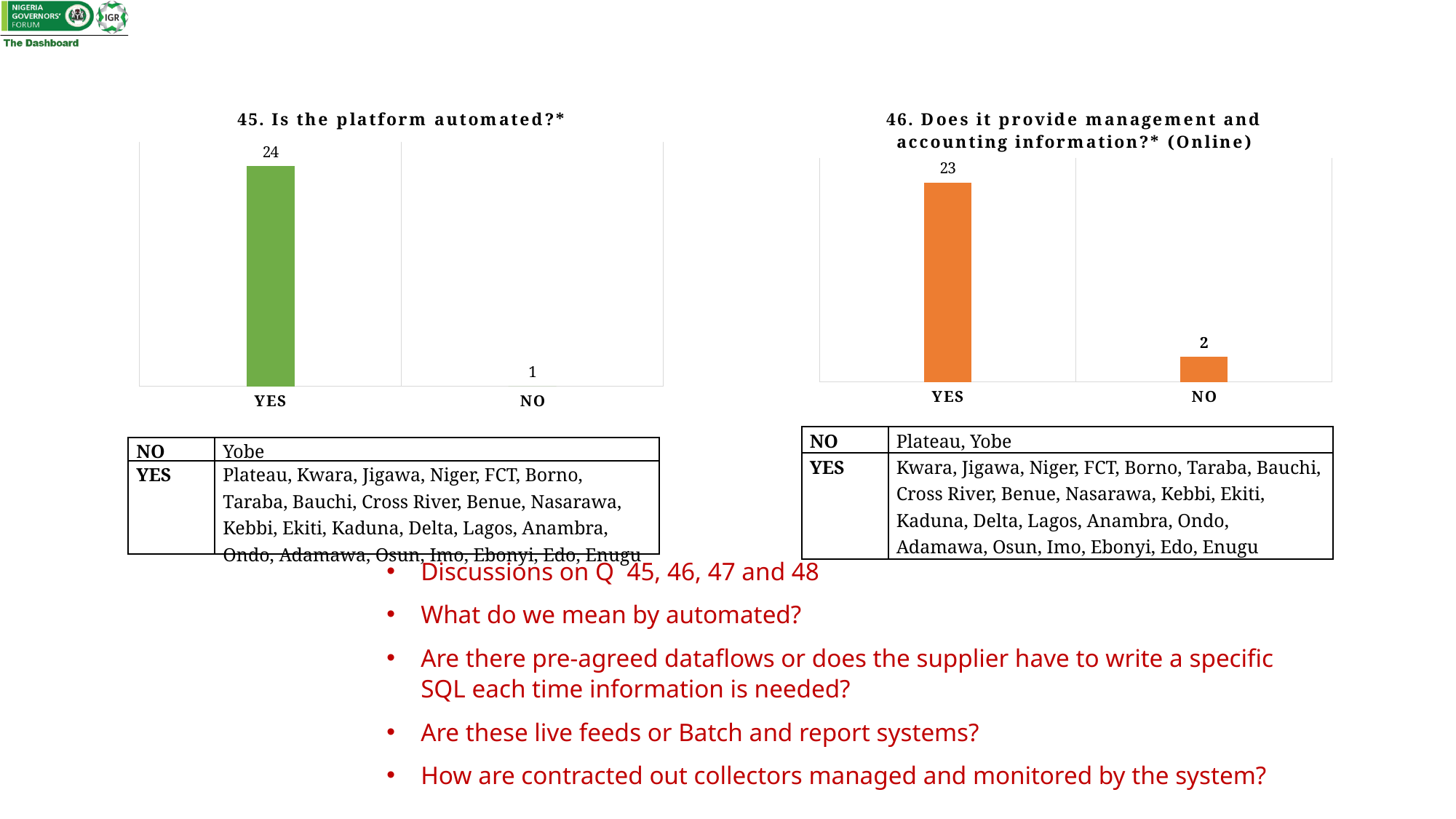
In the chart titled "46. Does it provide management and accounting information?* (Online)", what is the difference between the YES and NO values? 21 What colour are the bars in the chart titled "45. Is the platform automated?*"? Green In the chart titled "46. Does it provide management and accounting information?* (Online)", which category has the lowest value? NO In the chart titled "46. Does it provide management and accounting information?* (Online)", what is the value for YES? 23 In the chart titled "46. Does it provide management and accounting information?* (Online)", which is larger, YES or NO? YES In the chart titled "45. Is the platform automated?*", which category has the highest value? YES How many categories are shown in the chart titled "45. Is the platform automated?*"? 2 In the chart titled "45. Is the platform automated?*", what is the difference between the YES and NO values? 23 In the chart titled "45. Is the platform automated?*", what is the value for YES? 24 What type of chart is the chart titled "46. Does it provide management and accounting information?* (Online)"? Bar chart In the chart titled "45. Is the platform automated?*", what is the value for NO? 1 In the chart titled "46. Does it provide management and accounting information?* (Online)", what is the value for NO? 2